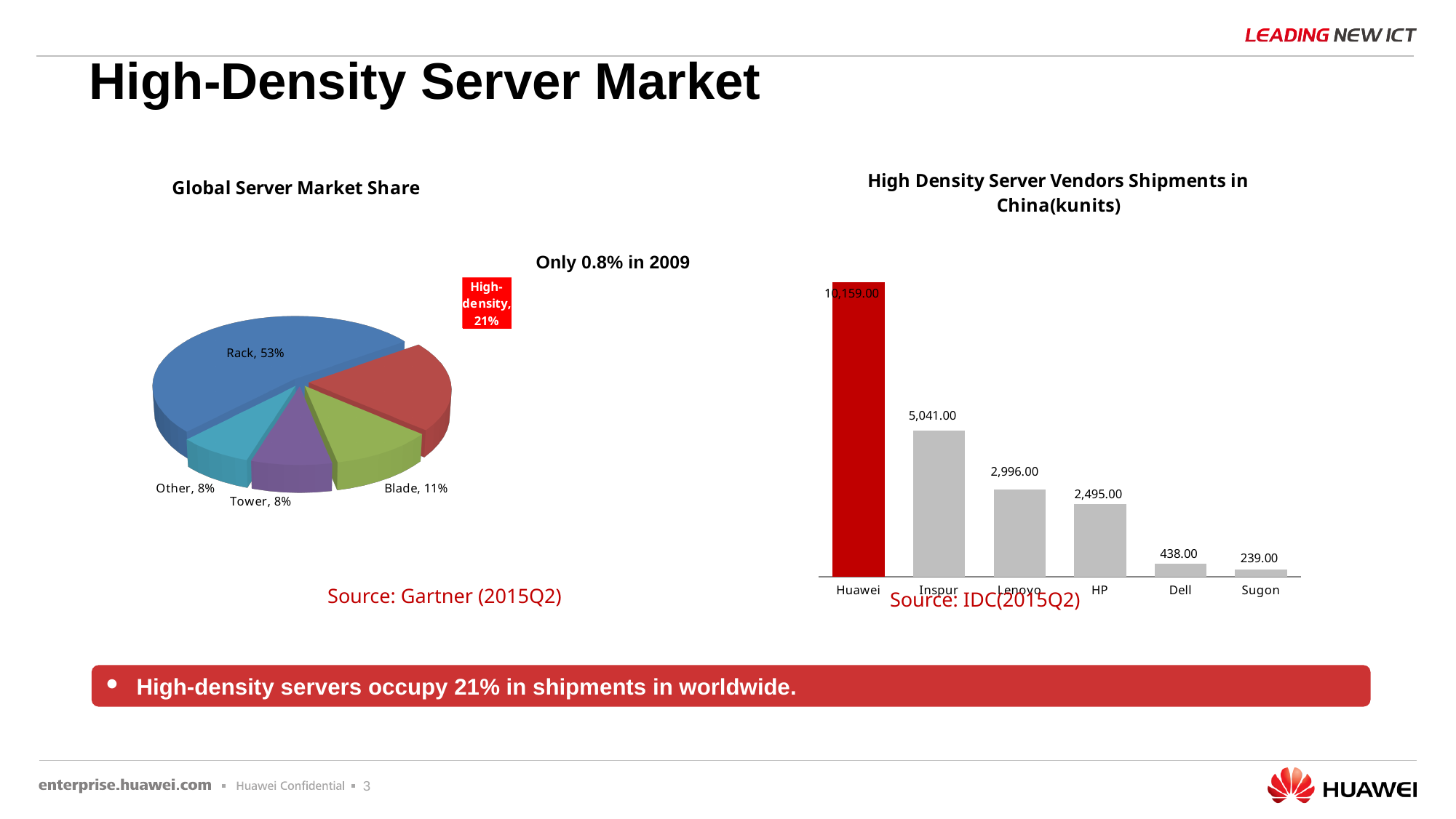
In the Global Server Market Share chart, what share does High-density hold? 21% In the Global Server Market Share chart, how much larger is the Rack share than the Blade share? 42% In the High Density Server Vendors Shipments in China chart, what is the value for Huawei? 10,159.00 In the High Density Server Vendors Shipments in China chart, which is larger, HP or Dell? HP In the Global Server Market Share chart, what kind of chart is used? Pie chart In the High Density Server Vendors Shipments in China chart, which vendor has the lowest shipments? Sugon In the Global Server Market Share chart, how many categories are shown in the pie? 5 In the High Density Server Vendors Shipments in China chart, how many vendors are shown? 6 In the High Density Server Vendors Shipments in China chart, what is the difference between Huawei and Inspur? 5,118.00 In the High Density Server Vendors Shipments in China chart, what is the value for Lenovo? 2,996.00 In the Global Server Market Share chart, what share does Rack hold? 53% In the Global Server Market Share chart, which category has the largest share? Rack